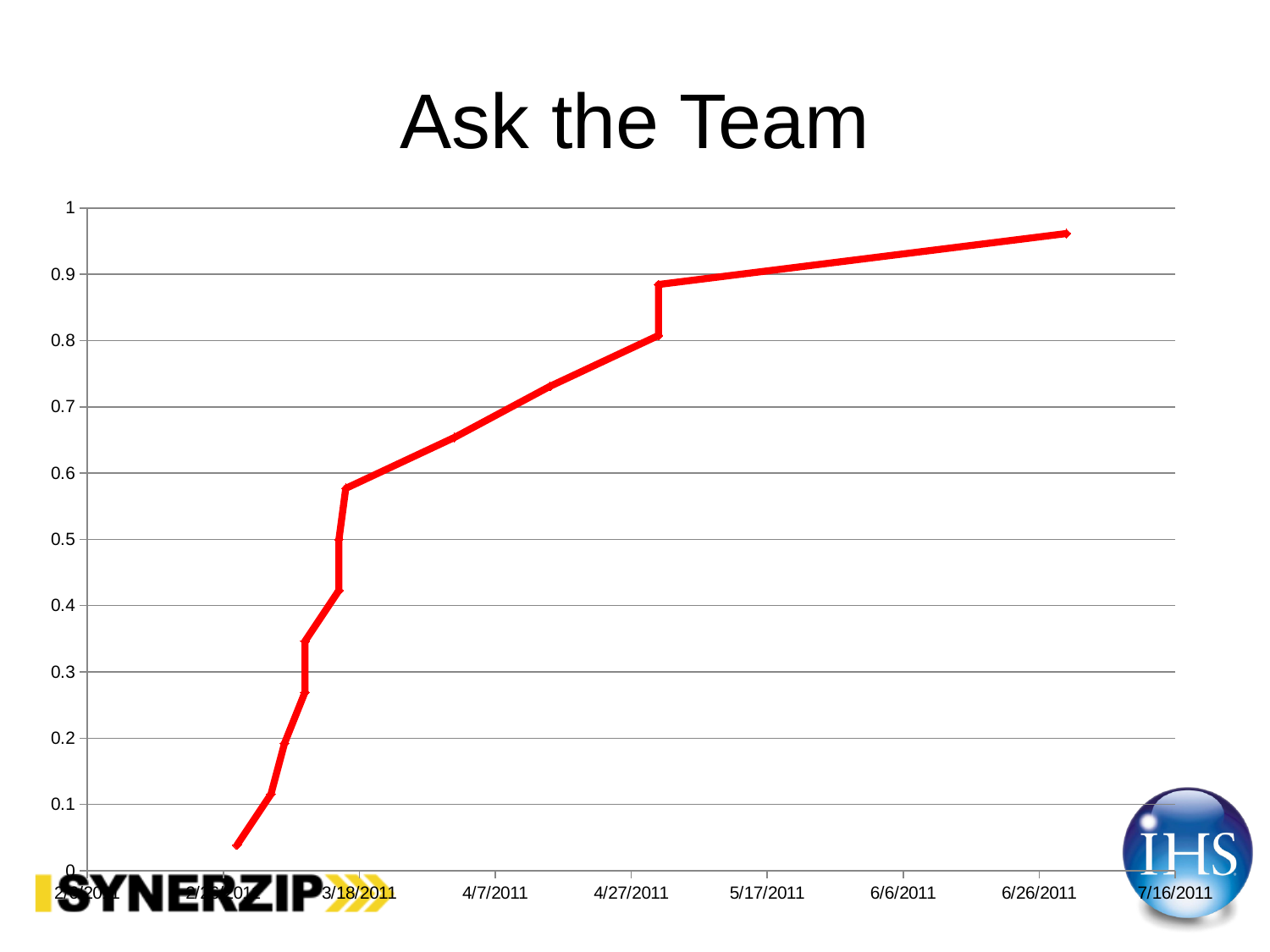
Is the value of the line at 3/18/2011 greater or less than 0.7? less What colour is the plotted line? red Is the lowest value plotted on the line greater or less than 0.1? less Is the line higher at 4/27/2011 or at 3/18/2011? 4/27/2011 How many lines are plotted on the chart? 1 What kind of chart is shown on the slide? line chart Is the highest value plotted on the line greater or less than 0.9? greater Do the values rise or fall along the x axis from 2/6/2011 to 7/16/2011? rise What is the title of the chart? Ask the Team Is the line higher at 6/6/2011 or at 4/7/2011? 6/6/2011 What is the maximum value shown on the y axis? 1